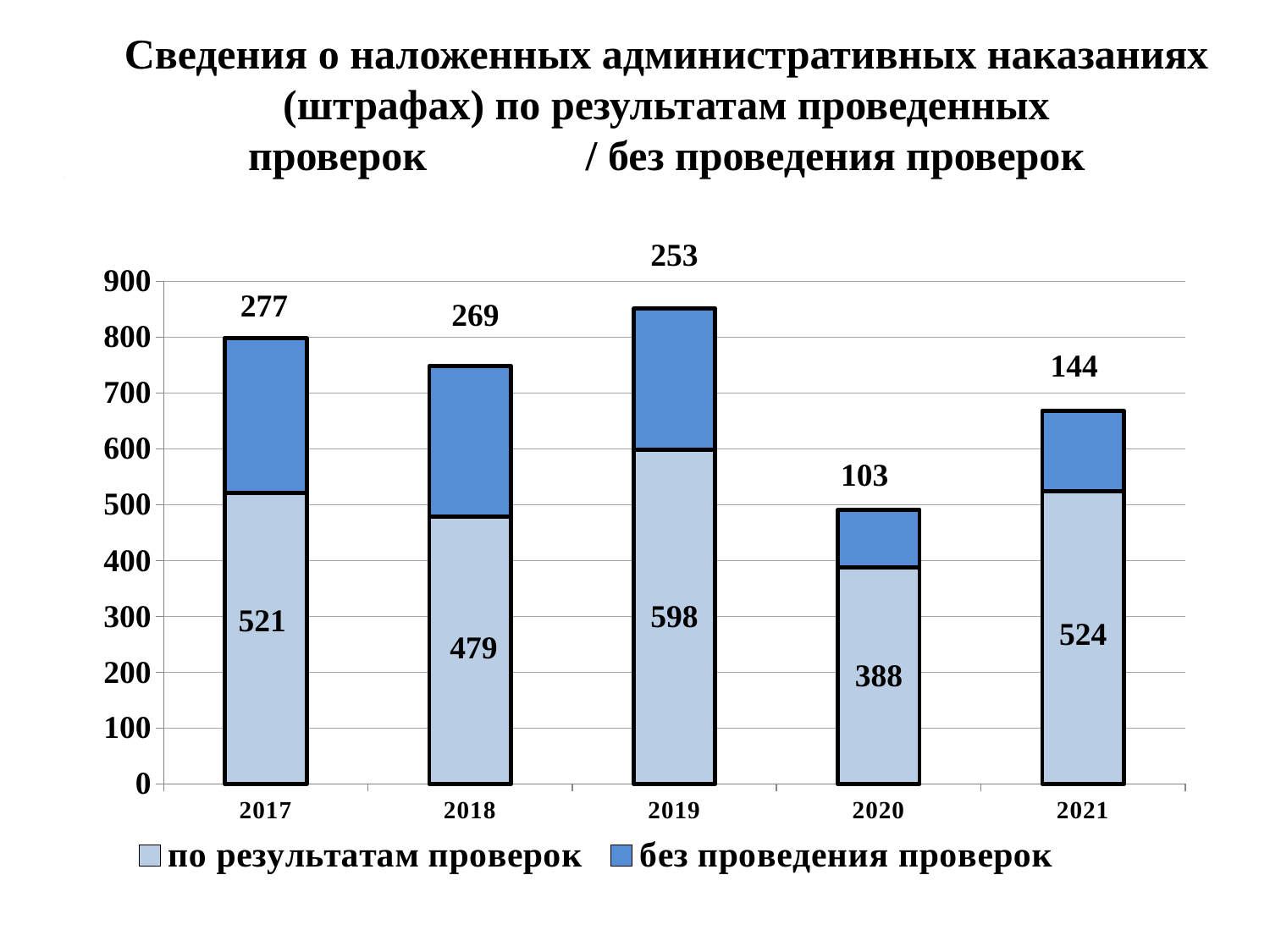
What is the total of the stacked bar for 2020? 491 Which is larger: the "без проведения проверок" value for 2018 or for 2021? 2018 What is the difference between the "по результатам проверок" values for 2019 and 2018? 119 What is the value for "по результатам проверок" in 2019? 598 What is the total of the stacked bar for 2017? 798 How many series does the legend list? 2 Which year has the lowest value for "по результатам проверок"? 2020 Which year has the highest value for "без проведения проверок"? 2017 What kind of chart is shown on the slide? Stacked bar chart How many years are shown on the x axis? 5 What is the value for "по результатам проверок" in 2021? 524 What is the value for "без проведения проверок" in 2020? 103